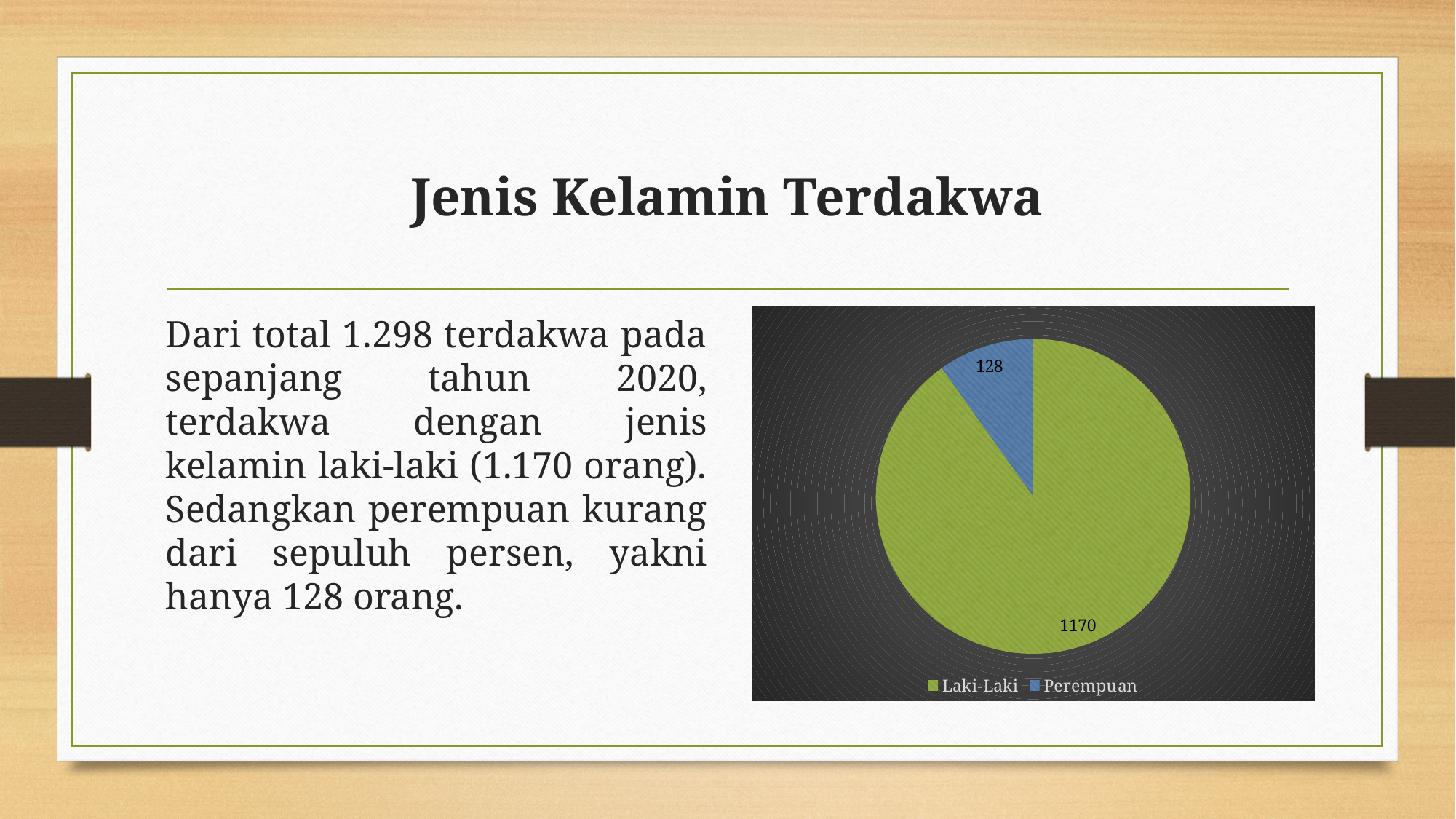
How many slices does the pie chart have? 2 What is the total of the two values shown in the pie chart? 1298 How many entries does the legend of the pie chart list? 2 What is the value for Perempuan in the pie chart? 128 What is the difference between the Laki-Laki and Perempuan values in the pie chart? 1042 What kind of chart is shown on the slide? pie chart What colour is the Laki-Laki slice in the pie chart? green What is the value for Laki-Laki in the pie chart? 1170 Which category has the largest slice in the pie chart? Laki-Laki Which is larger in the pie chart, Laki-Laki or Perempuan? Laki-Laki Which category has the smallest slice in the pie chart? Perempuan